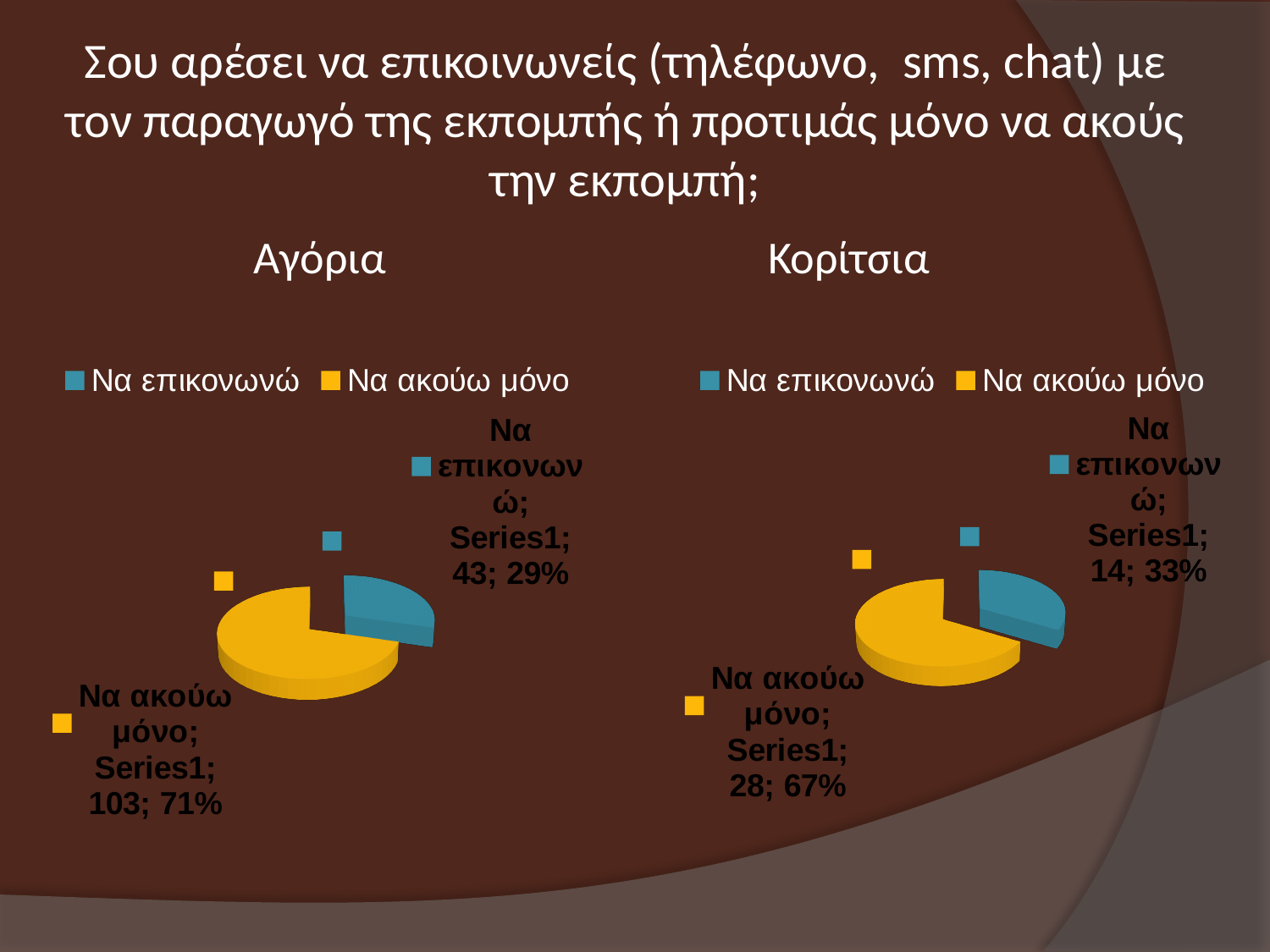
In the Αγόρια pie chart, what is the difference between the values for Να ακούω μόνο and Να επικονωνώ? 60 In the Αγόρια pie chart, what is the value for Να ακούω μόνο? 103 In the Κορίτσια pie chart, what is the difference between the values for Να ακούω μόνο and Να επικονωνώ? 14 Which is larger: the value for Να επικονωνώ in the Αγόρια chart or the value for Να επικονωνώ in the Κορίτσια chart? Αγόρια How many categories does the Κορίτσια pie chart show? 2 In the Αγόρια pie chart, what colour is the Να ακούω μόνο slice? Yellow In the Κορίτσια pie chart, what percentage share does Να ακούω μόνο have? 67% In the Αγόρια pie chart, what percentage share does Να επικονωνώ have? 29% In the Αγόρια pie chart, which category has the largest slice? Να ακούω μόνο In the Κορίτσια pie chart, what is the value for Να επικονωνώ? 14 In the Κορίτσια pie chart, which category has the smallest slice? Να επικονωνώ What type of chart is used for the Αγόρια data? Pie chart